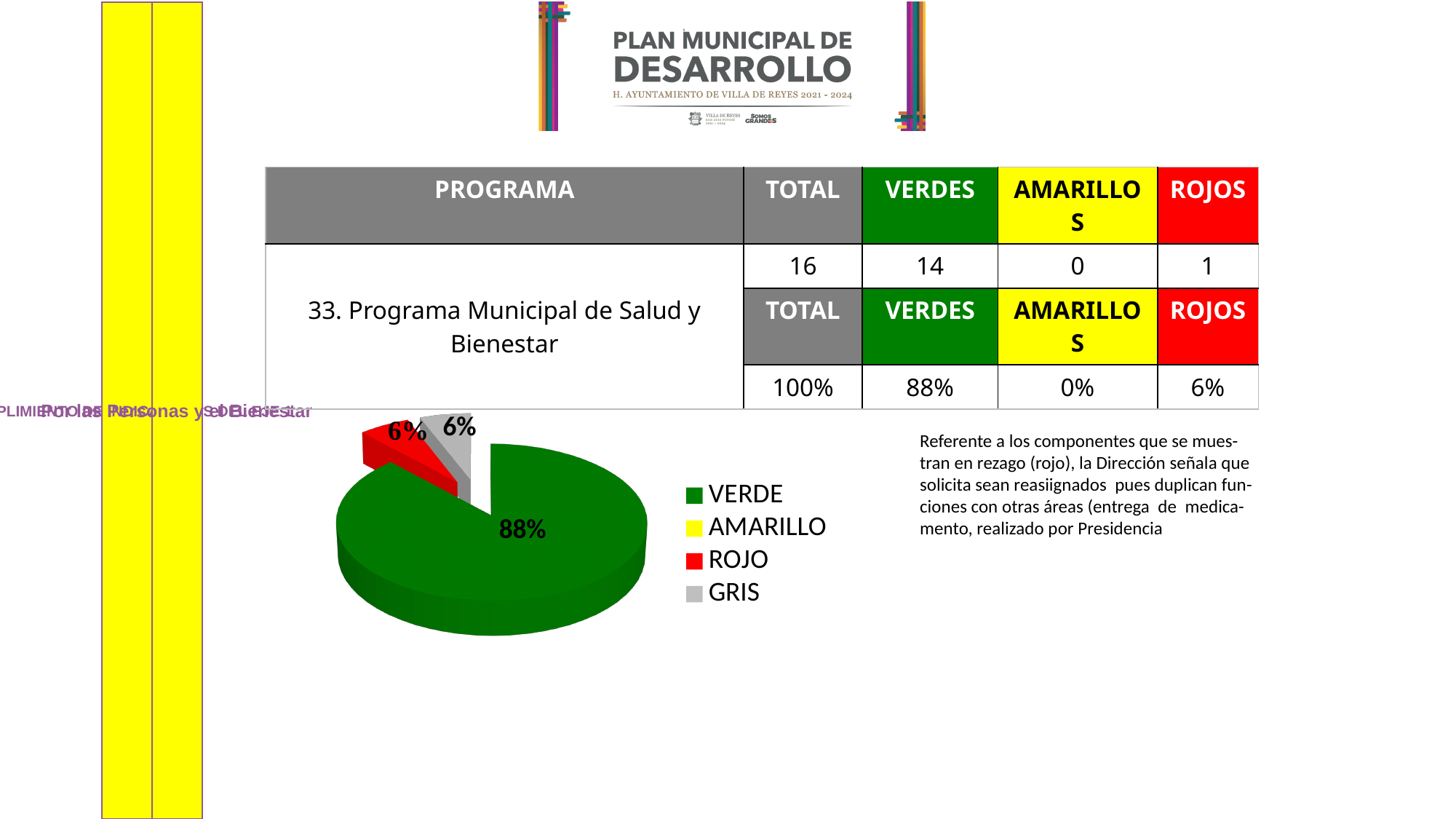
What percentage does the ROJO slice of the pie chart represent? 6% Which legend entry of the pie chart is shown in yellow? AMARILLO What share of the pie does the VERDE slice take? 88% What colour is used for the ROJO category in the pie chart? red Which is larger in the pie chart, the VERDE slice or the ROJO slice? VERDE What is the difference in percentage points between the VERDE slice and the ROJO slice? 82 What percentage does the VERDE slice of the pie chart represent? 88% What percentage does the GRIS slice of the pie chart represent? 6% What kind of chart is shown on the slide? pie chart How many entries does the pie chart's legend list? 4 Which category has the largest slice in the pie chart? VERDE